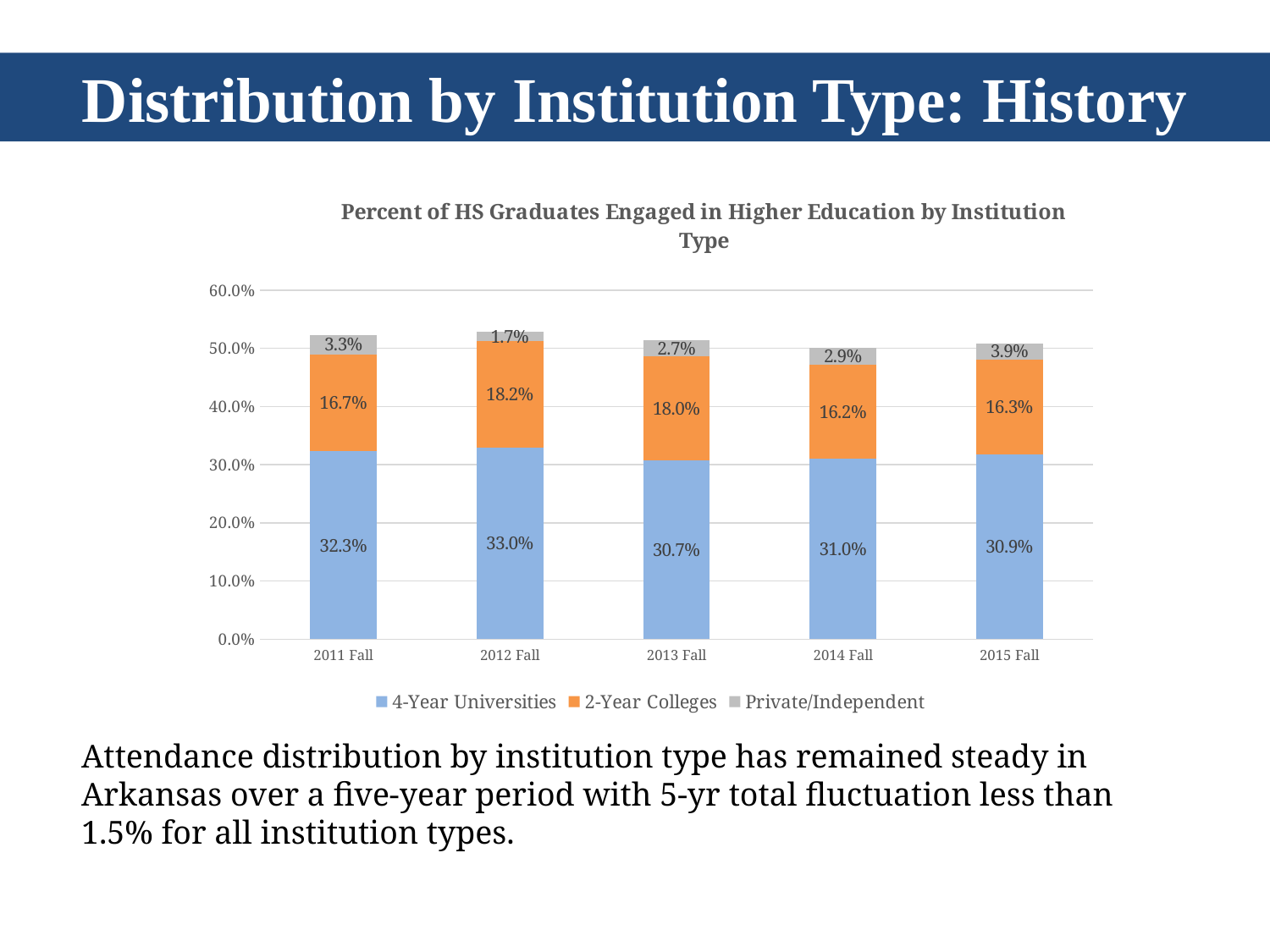
How many series does the legend list? 3 How many fall terms are shown on the x axis? 5 In which fall term is the Private/Independent value lowest? 2012 Fall In which fall term is the 4-Year Universities value highest? 2012 Fall What is the value for Private/Independent in 2015 Fall? 3.9% Which is larger: the 4-Year Universities value in 2013 Fall or in 2014 Fall? 2014 Fall What is the total of the stacked bar for 2011 Fall? 52.3% What is the value for 4-Year Universities in 2012 Fall? 33.0% What is the difference between the 2-Year Colleges values in 2012 Fall and 2011 Fall? 1.5% What type of chart is shown on the slide? Stacked bar chart What is the title of the chart? Percent of HS Graduates Engaged in Higher Education by Institution Type What is the value for 2-Year Colleges in 2014 Fall? 16.2%